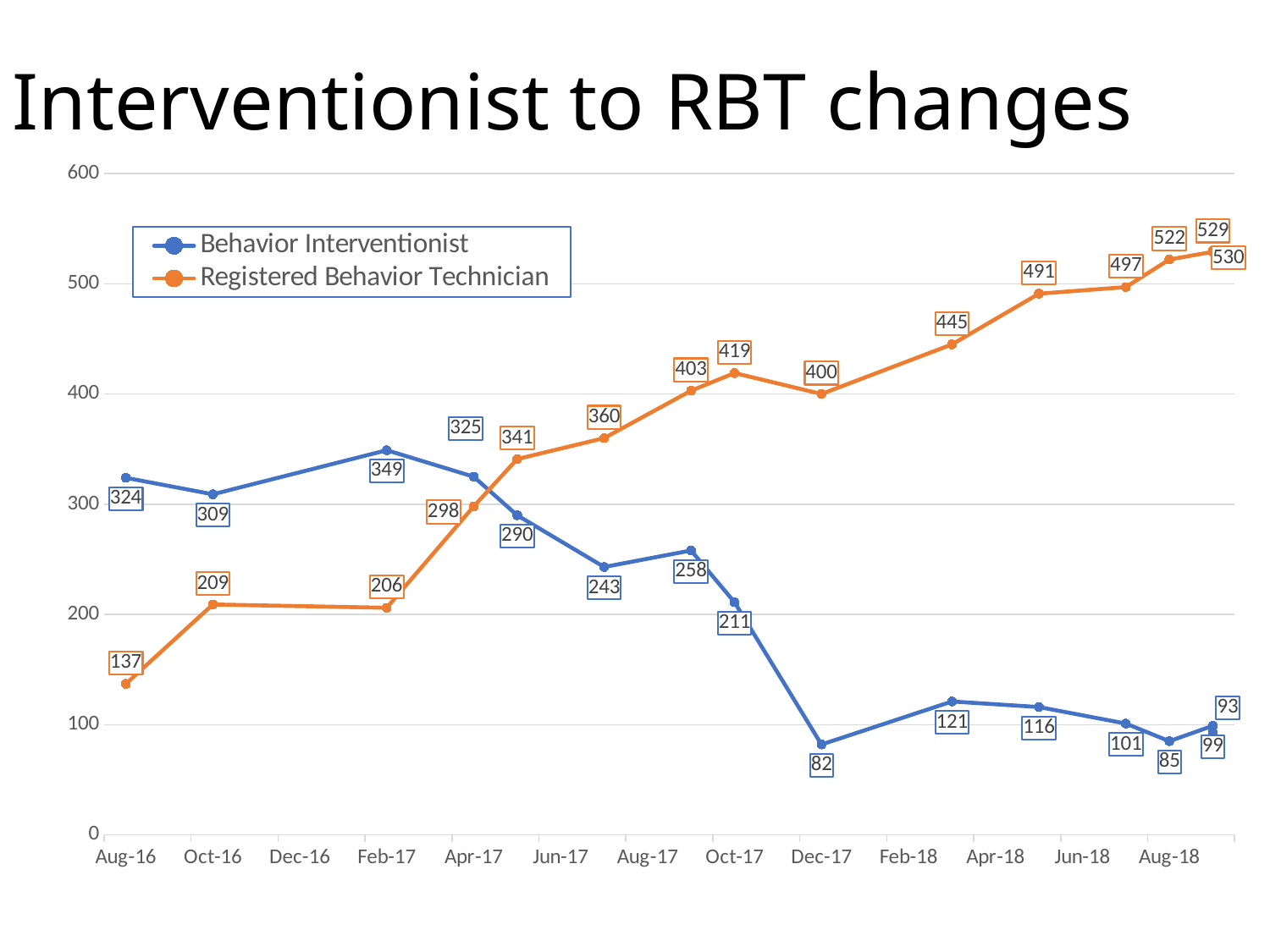
At Oct-16, which series has the higher value? Behavior Interventionist How many series does the legend list? 2 What is the Registered Behavior Technician value at Dec-17? 400 What kind of chart is shown on the slide? Line chart What is the lowest value of the Registered Behavior Technician series? 137 Does the Registered Behavior Technician series generally rise or fall from Aug-16 to Aug-18? Rise What is the lowest value reached by the Behavior Interventionist series? 82 What is the Behavior Interventionist value at Aug-16? 324 How many data points are plotted for the Behavior Interventionist series? 15 At Dec-17, what is the difference between the Registered Behavior Technician value and the Behavior Interventionist value? 318 What is the Registered Behavior Technician value at Feb-17? 206 What is the highest value reached by the Behavior Interventionist series? 349